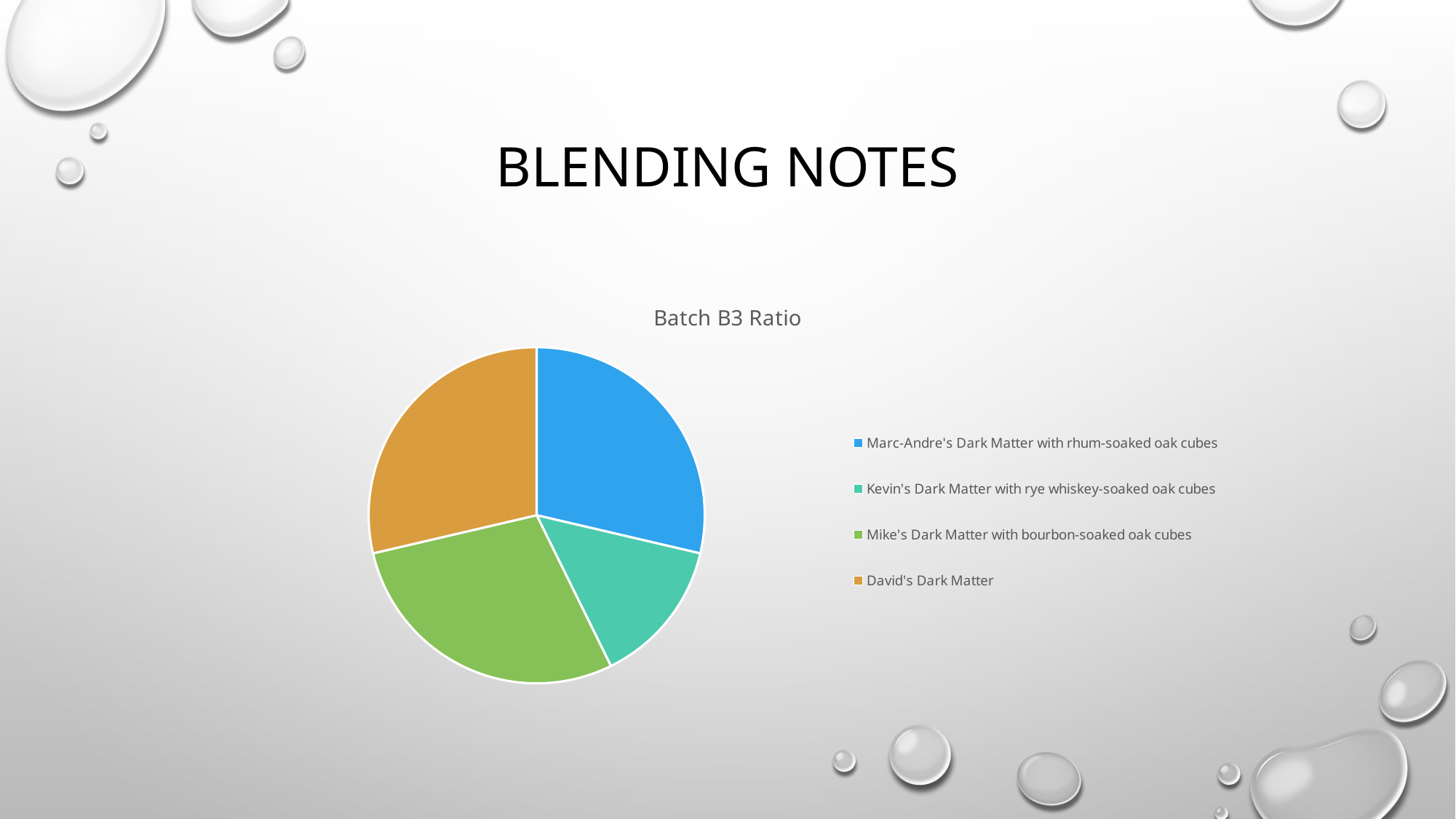
Which category has the smallest slice of the pie? Kevin's Dark Matter with rye whiskey-soaked oak cubes How many slices does the pie chart have? 4 What kind of chart is shown on the slide? Pie chart What colour is the slice for David's Dark Matter? Orange Which slice is larger: Kevin's Dark Matter with rye whiskey-soaked oak cubes or Marc-Andre's Dark Matter with rhum-soaked oak cubes? Marc-Andre's Dark Matter with rhum-soaked oak cubes What is the title of the chart? Batch B3 Ratio Which slice is larger: Mike's Dark Matter with bourbon-soaked oak cubes or Kevin's Dark Matter with rye whiskey-soaked oak cubes? Mike's Dark Matter with bourbon-soaked oak cubes How many entries does the chart legend list? 4 Which slice is larger: Kevin's Dark Matter with rye whiskey-soaked oak cubes or David's Dark Matter? David's Dark Matter